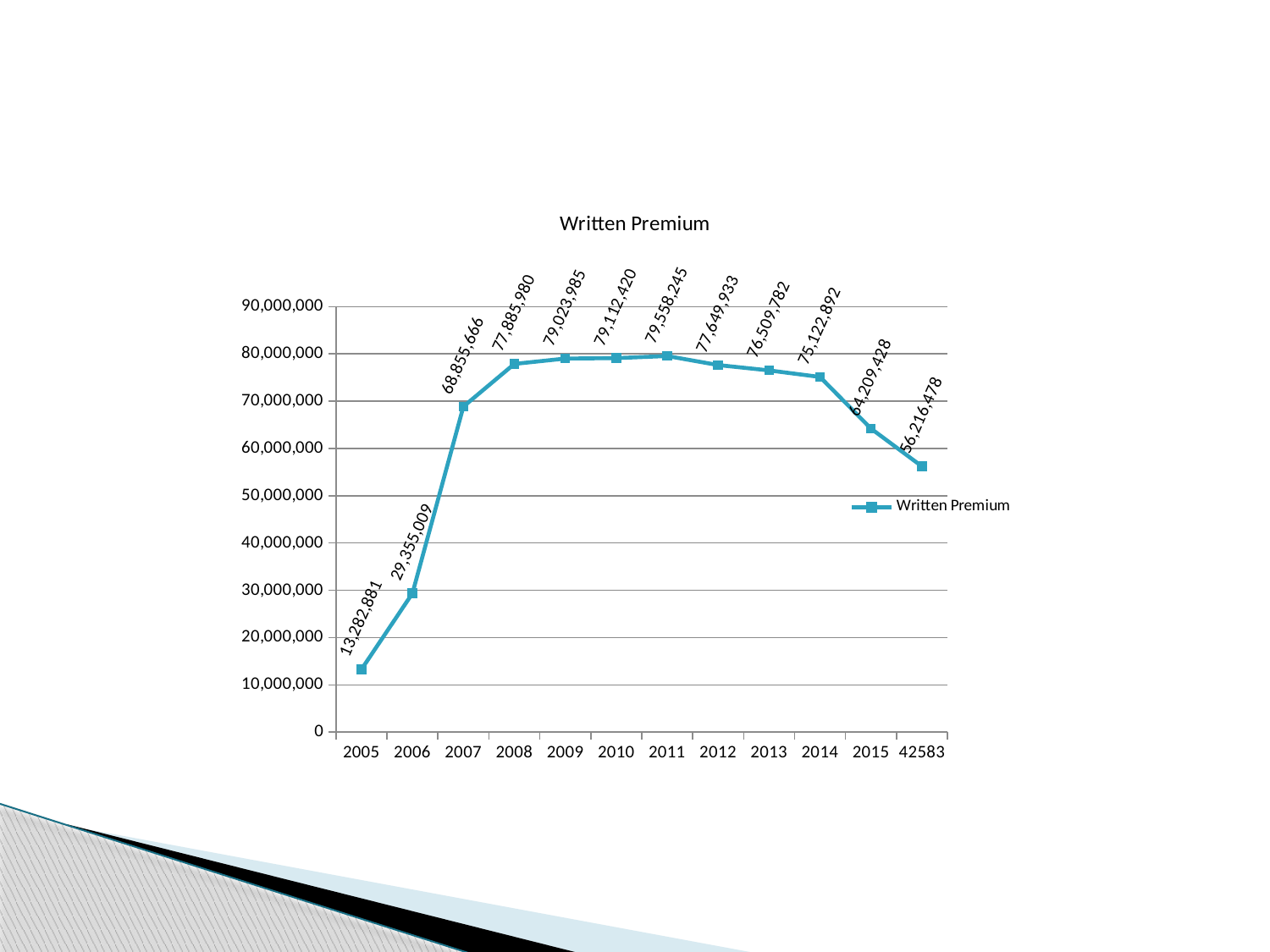
Which is larger, the Written Premium for 2007 or for 2014? 2014 What is the difference between the Written Premium in 2011 and in 2005? 66,275,364 What is the Written Premium value for 2005? 13,282,881 What is the Written Premium value for 2015? 64,209,428 Which year has the highest Written Premium? 2011 What is the Written Premium value for 2011? 79,558,245 What is the Written Premium value for the last point on the x axis, labelled 42583? 56,216,478 Does the Written Premium rise or fall from 2011 to the end of the x axis? Fall What is the difference between the Written Premium in 2015 and the point labelled 42583? 7,992,950 What kind of chart is shown on the slide? Line chart Which year has the lowest Written Premium? 2005 How many data points are plotted on the chart? 12